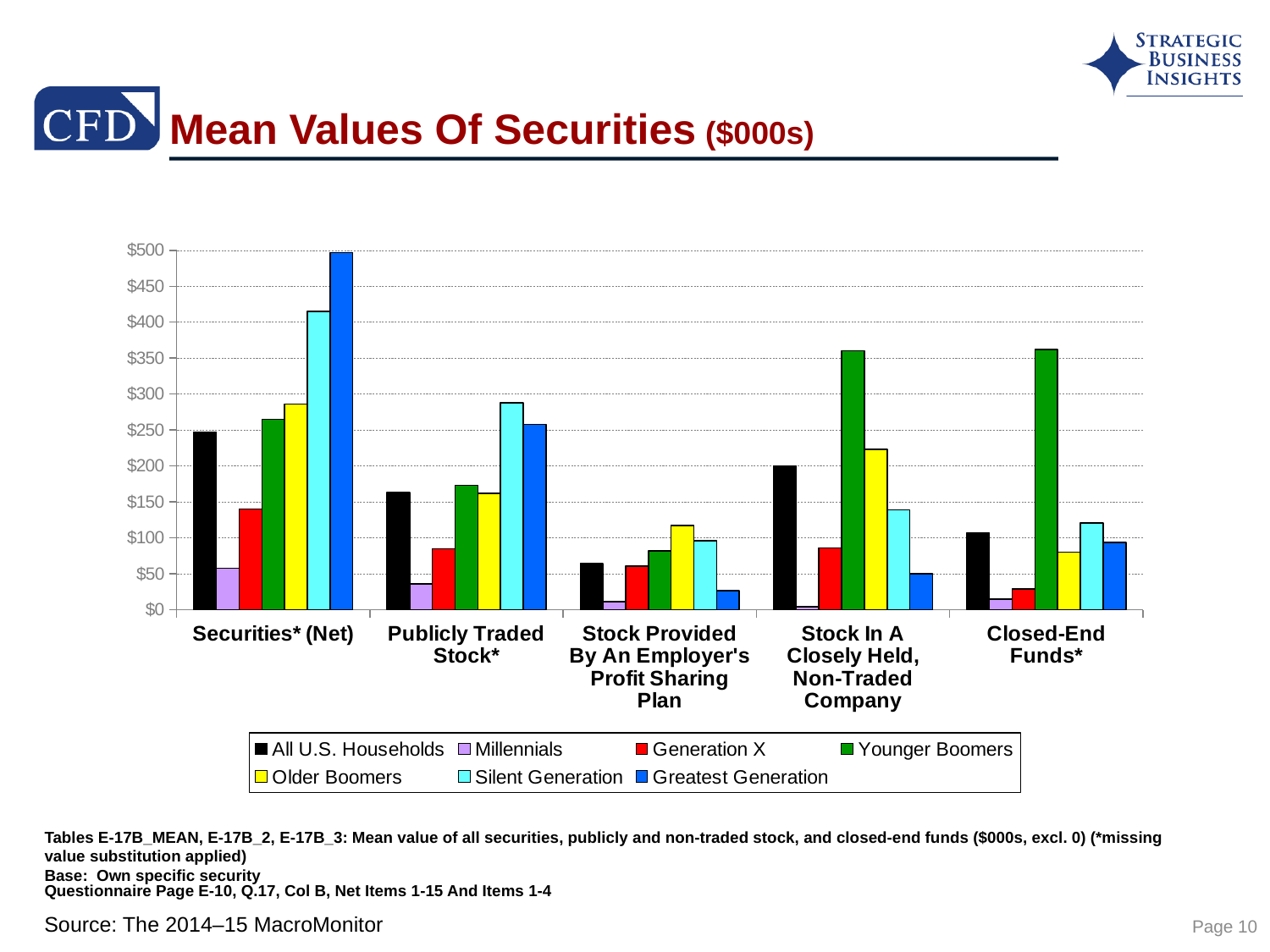
Is the value for Younger Boomers in Closed-End Funds* greater or less than $300? greater For Securities* (Net), which generation has the lowest mean value? Millennials What colour represents Younger Boomers in the legend? Green How many security categories are shown along the x axis? 5 For Closed-End Funds*, which series has the lowest bar? Millennials Is the value for All U.S. Households in Stock In A Closely Held, Non-Traded Company greater or less than $150? greater For Securities* (Net), which generation has the highest mean value? Greatest Generation For Stock In A Closely Held, Non-Traded Company, which series has the highest bar? Younger Boomers How many series does the legend list? 7 For Publicly Traded Stock*, which is larger: the Silent Generation bar or the Greatest Generation bar? Silent Generation Is the value for Greatest Generation in Securities* (Net) greater or less than $450? greater What kind of chart is shown on the slide? Bar chart